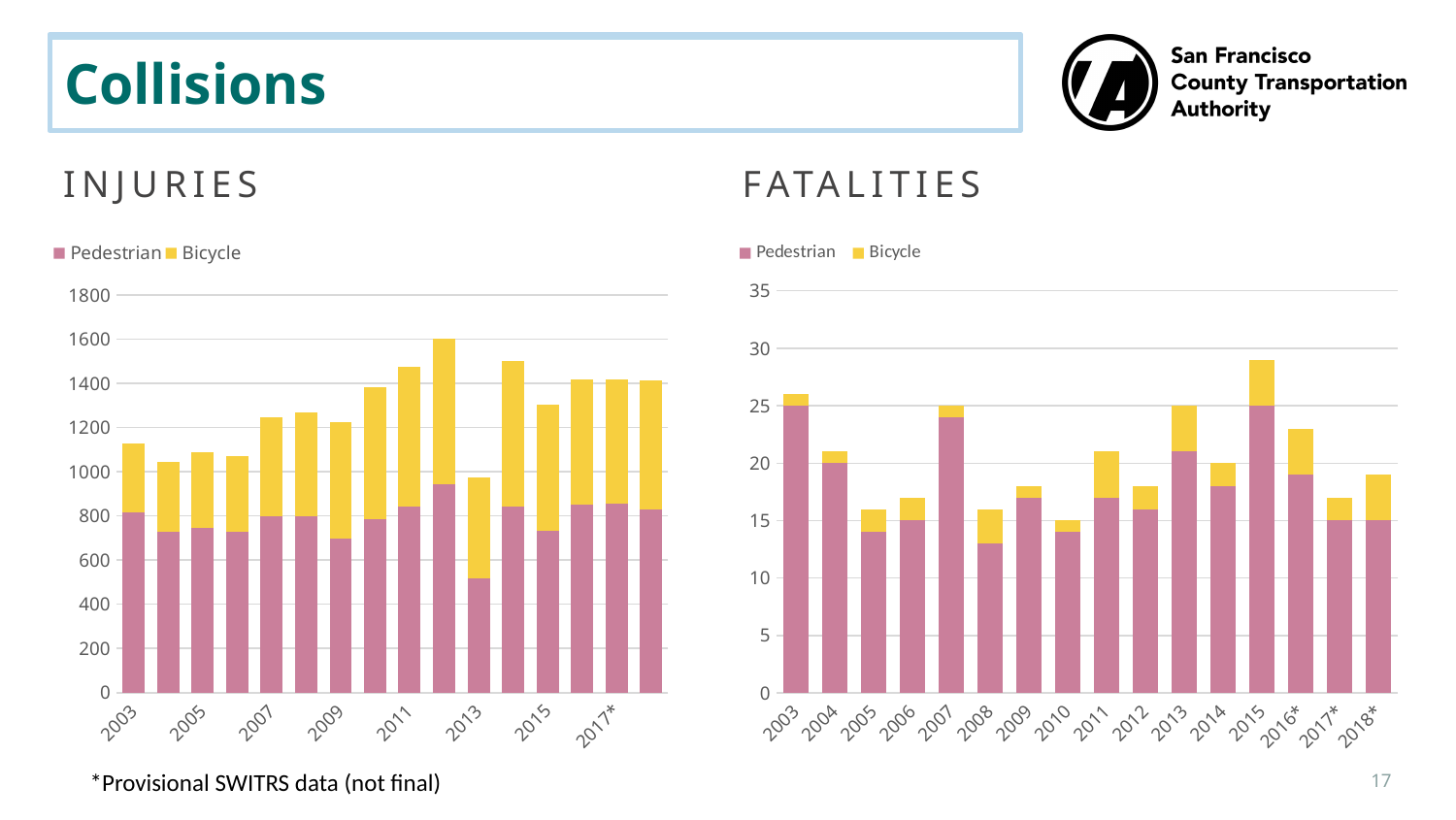
In the Fatalities chart, is the Pedestrian value for 2008 greater or less than 15? less In the Injuries chart, is the total for 2012 greater or less than 1400? greater In the Injuries chart, which year has the lowest total injuries? 2013 In the Injuries chart, which year has the highest total injuries? 2012 How many series does the legend of the Fatalities chart list? 2 How many years (bars) are shown in the Fatalities chart? 16 What kind of chart is the Injuries chart? Stacked bar chart In the Fatalities chart, which year has the larger Pedestrian value, 2007 or 2008? 2007 In the Fatalities chart, is the total for 2015 greater or less than 25? greater In the Fatalities chart, which year has the highest total fatalities? 2015 In the Injuries chart, which colour represents the Bicycle series? Yellow